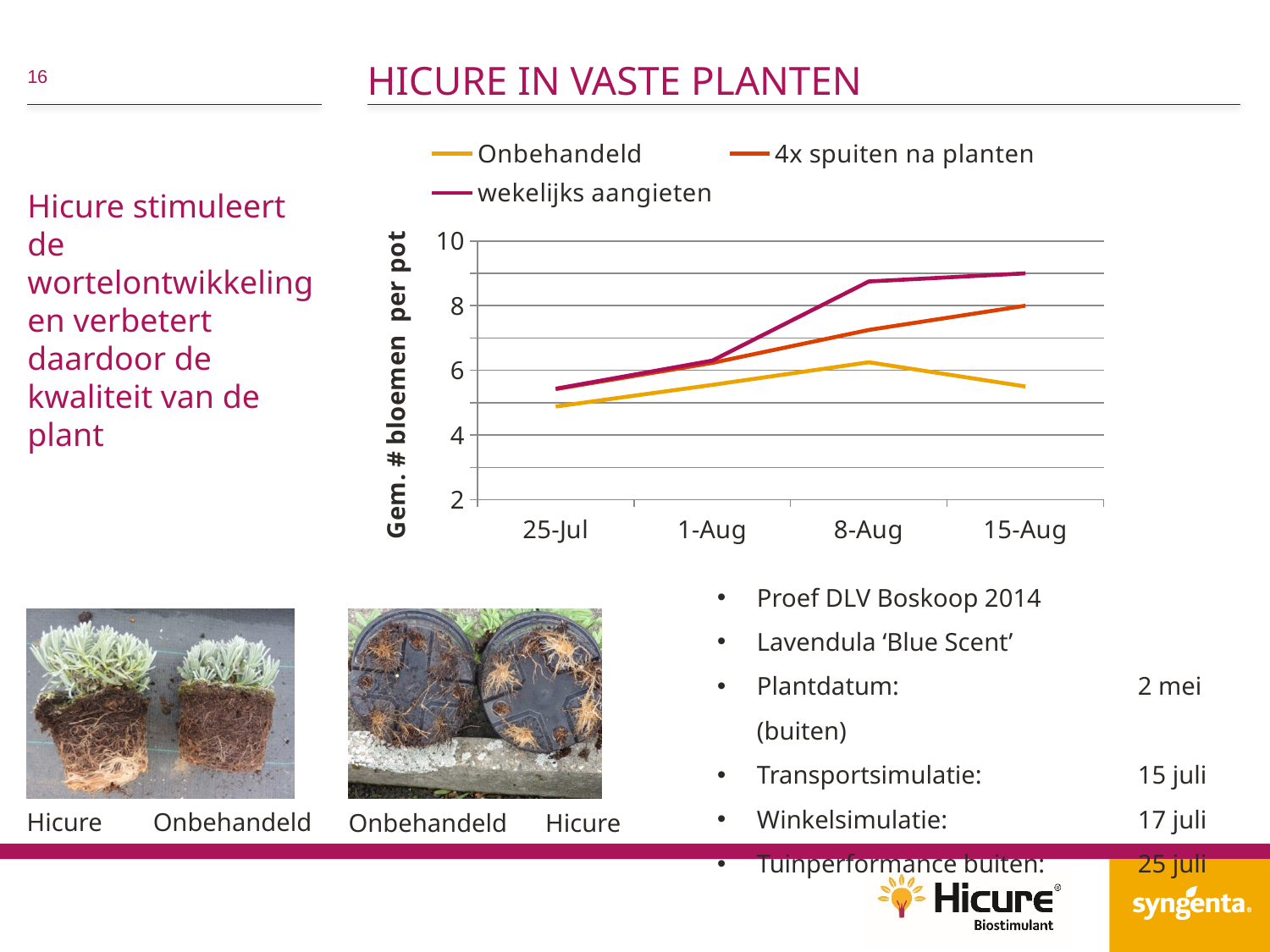
Is the value for 4x spuiten na planten at 8-Aug greater or less than 6? greater Does the wekelijks aangieten line rise or fall from 25-Jul to 15-Aug? rise Which series has the highest value at 15-Aug? wekelijks aangieten Does the Onbehandeld line rise or fall between 8-Aug and 15-Aug? fall How many series does the chart legend list? 3 What is the label on the y axis of the chart? Gem. # bloemen per pot Is the value for wekelijks aangieten at 15-Aug greater or less than 8? greater What kind of chart is shown on the slide? line chart How many dates are shown on the x axis of the chart? 4 At 8-Aug, which is larger: wekelijks aangieten or 4x spuiten na planten? wekelijks aangieten Which series has the lowest value at 15-Aug? Onbehandeld Is the value for Onbehandeld at 25-Jul greater or less than 6? less